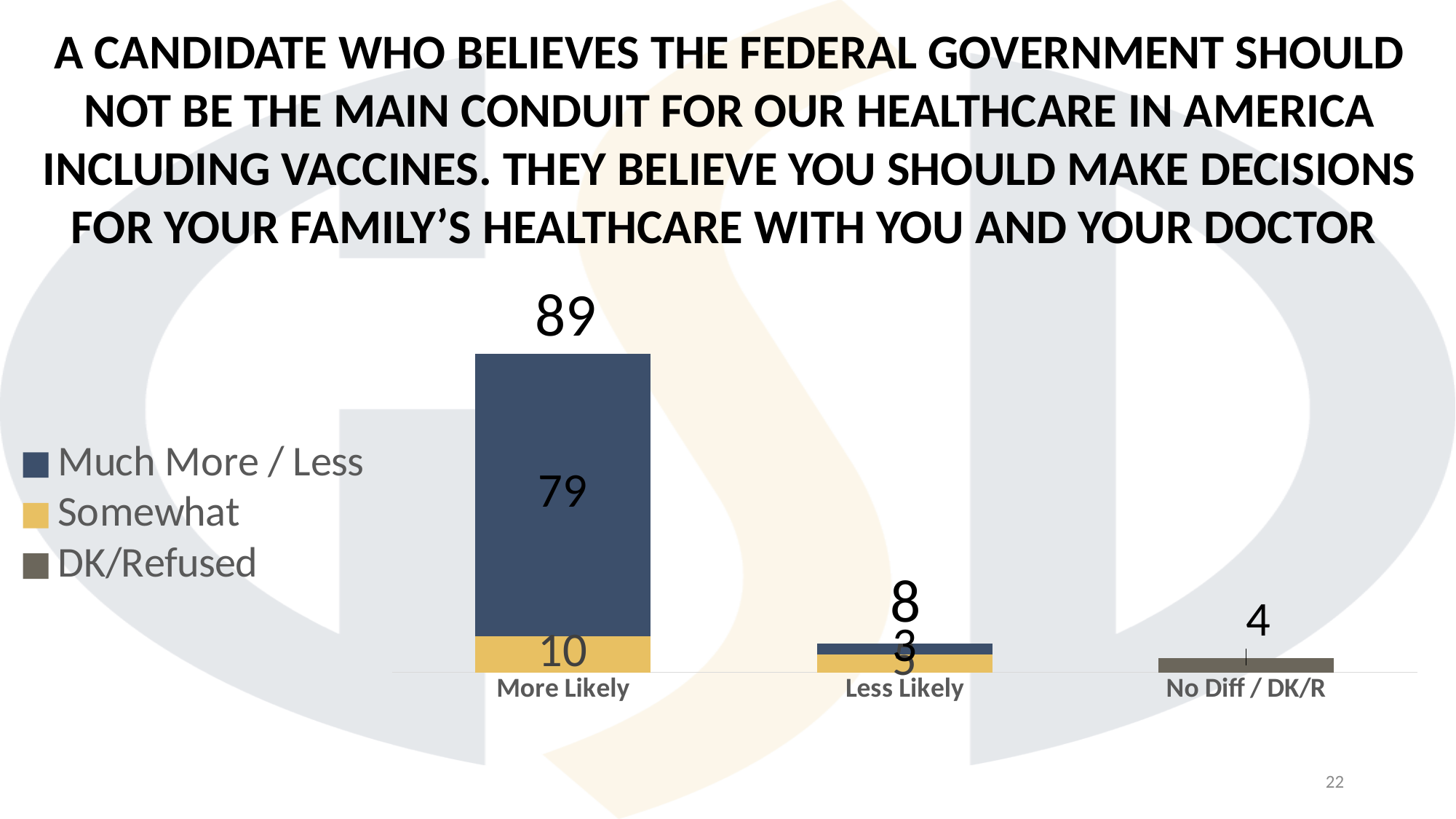
What is the Somewhat value for More Likely? 10 What is the Much More / Less value for More Likely? 79 What is the value for No Diff / DK/R? 4 What type of chart is shown on the slide? Stacked bar chart What is the difference between the total for More Likely and the total for Less Likely? 81 Which category has the highest total? More Likely How many series does the legend list? 3 What is the total value of the Less Likely bar? 8 Which legend entry is shown in yellow? Somewhat What is the Much More / Less value for Less Likely? 3 How many categories are shown on the x axis of the chart? 3 What is the total value of the More Likely bar? 89